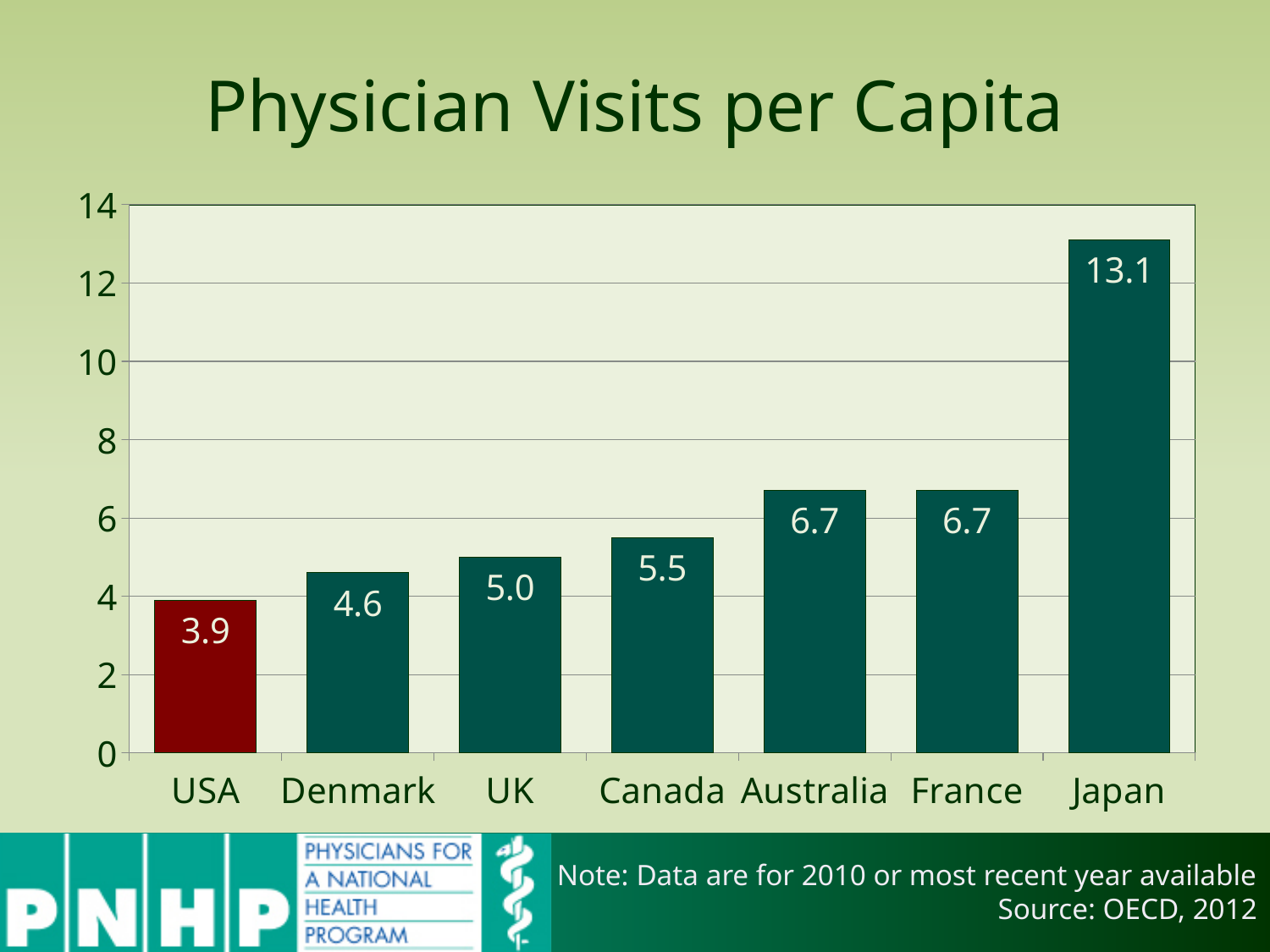
What is the difference between the values for Japan and the USA? 9.2 What is the value for the USA? 3.9 Is the value for Japan greater or less than 12? greater What is the title of the chart? Physician Visits per Capita What is the value for Canada? 5.5 Which country has the highest physician visits per capita? Japan What kind of chart is shown on the slide? bar chart Which is larger, the value for the UK or the value for Australia? Australia What is the difference between the values for Canada and Denmark? 0.9 How many countries are shown on the chart? 7 What is the value for Japan? 13.1 Which country has the lowest physician visits per capita? USA